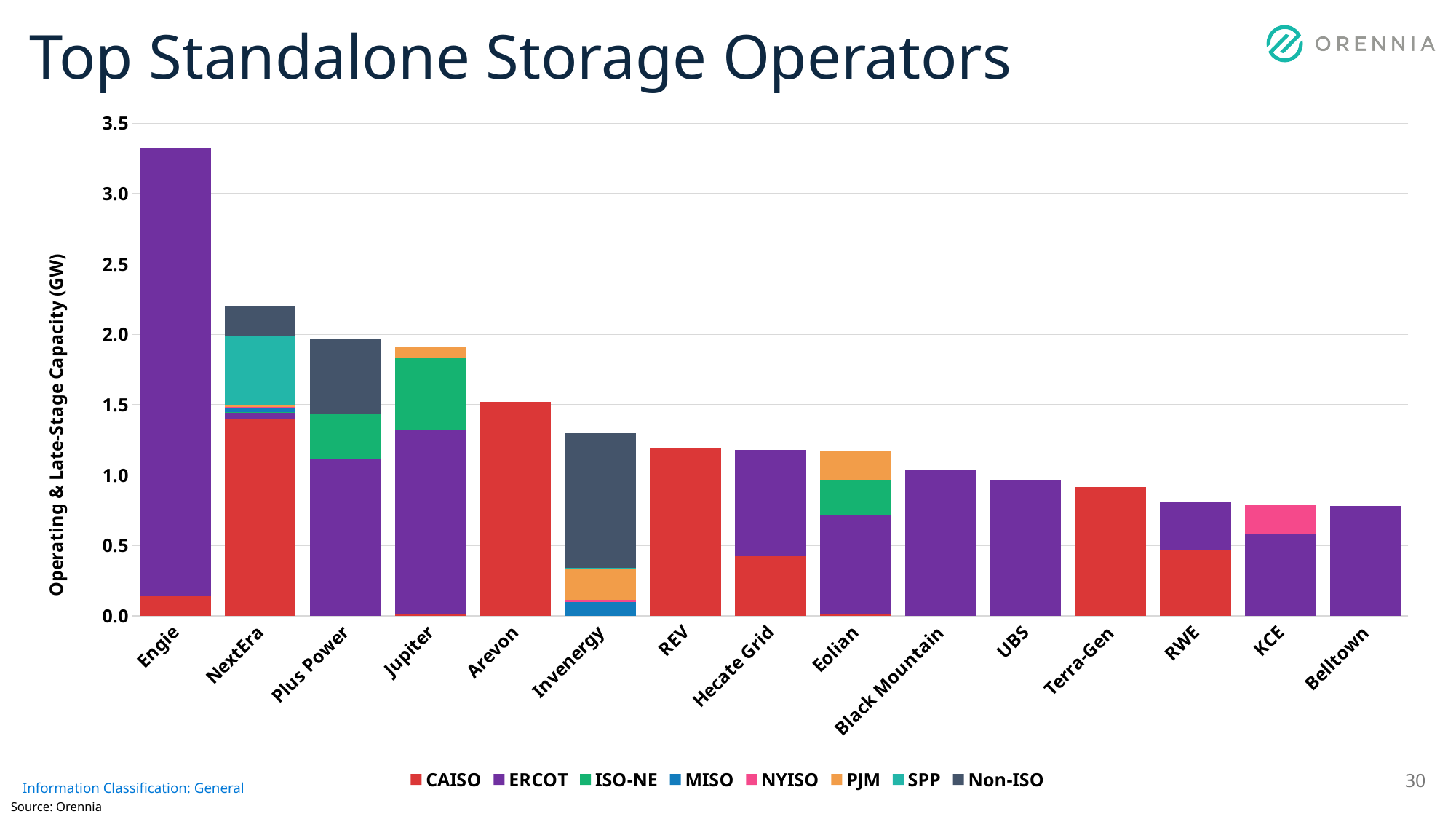
How many operators are shown on the x axis of the chart? 15 What kind of chart is shown on the slide? Stacked bar chart Is the total value for RWE greater or less than 1.0? less Which has the larger total capacity, Arevon or Invenergy? Arevon Do the total bar heights generally rise or fall from left to right across the operators? Fall What is the label of the y axis? Operating & Late-Stage Capacity (GW) Is the total value for Invenergy greater or less than 1.5? less Is the total value for NextEra greater or less than 2.0? greater How many series does the legend list? 8 Which has the larger total capacity, Terra-Gen or RWE? Terra-Gen Which operator has the highest total operating and late-stage capacity? Engie